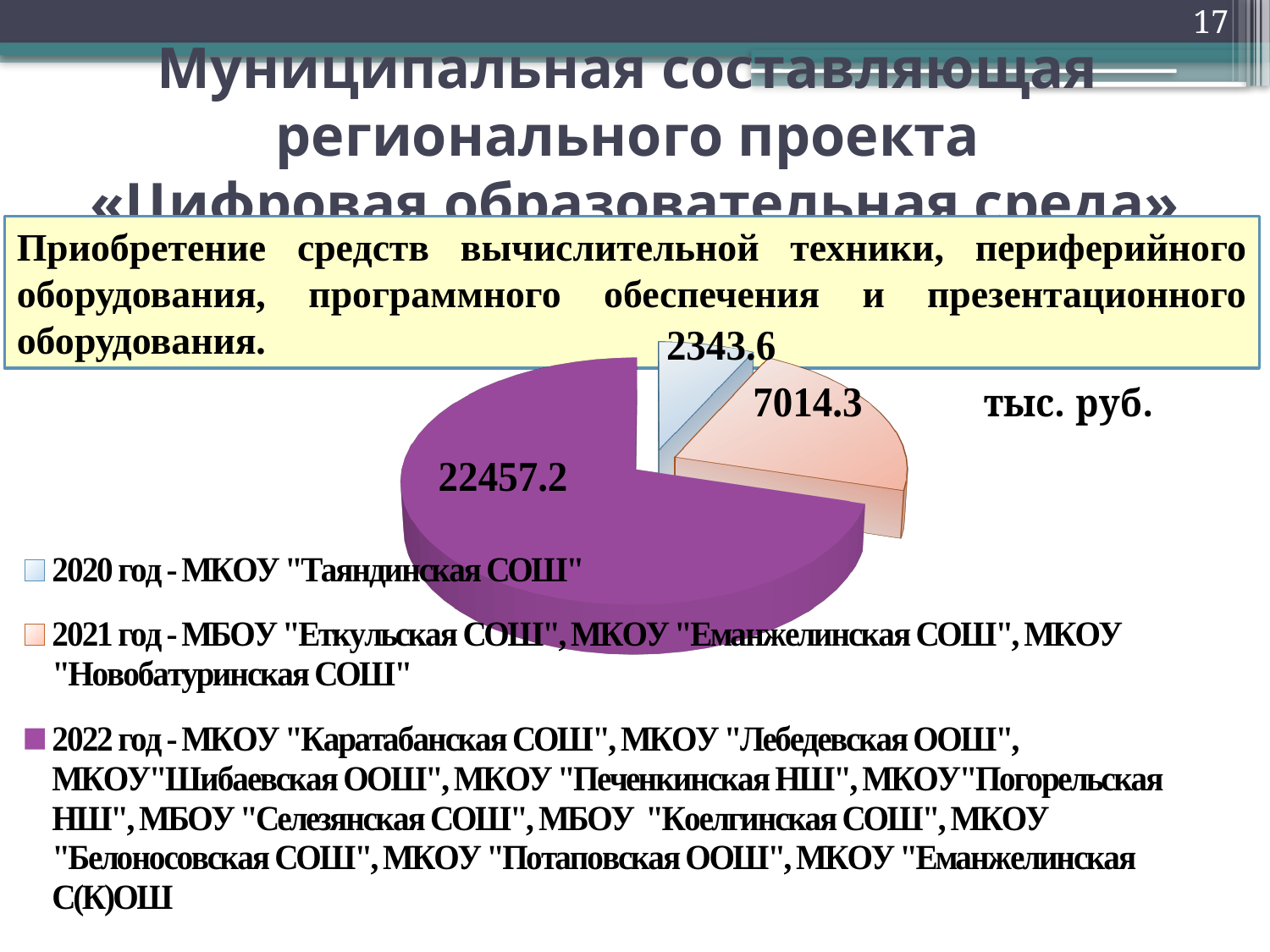
What is the value of the slice for 2021 год? 7014.3 What is the difference between the 2021 год value and the 2020 год value? 4670.7 What is the total of all three slices in the pie chart? 31815.1 Which year has the largest slice in the pie chart? 2022 год Which year has the smallest slice in the pie chart? 2020 год Which is larger, the value for 2021 год or the value for 2020 год? 2021 год What is the value of the slice for 2020 год (МКОУ "Таяндинская СОШ")? 2343.6 What is the value of the slice for 2022 год? 22457.2 What type of chart is shown on the slide? Pie chart In what units are the values in the pie chart given? тыс. руб. What is the difference between the 2022 год value and the 2021 год value? 15442.9 How many slices does the pie chart have? 3